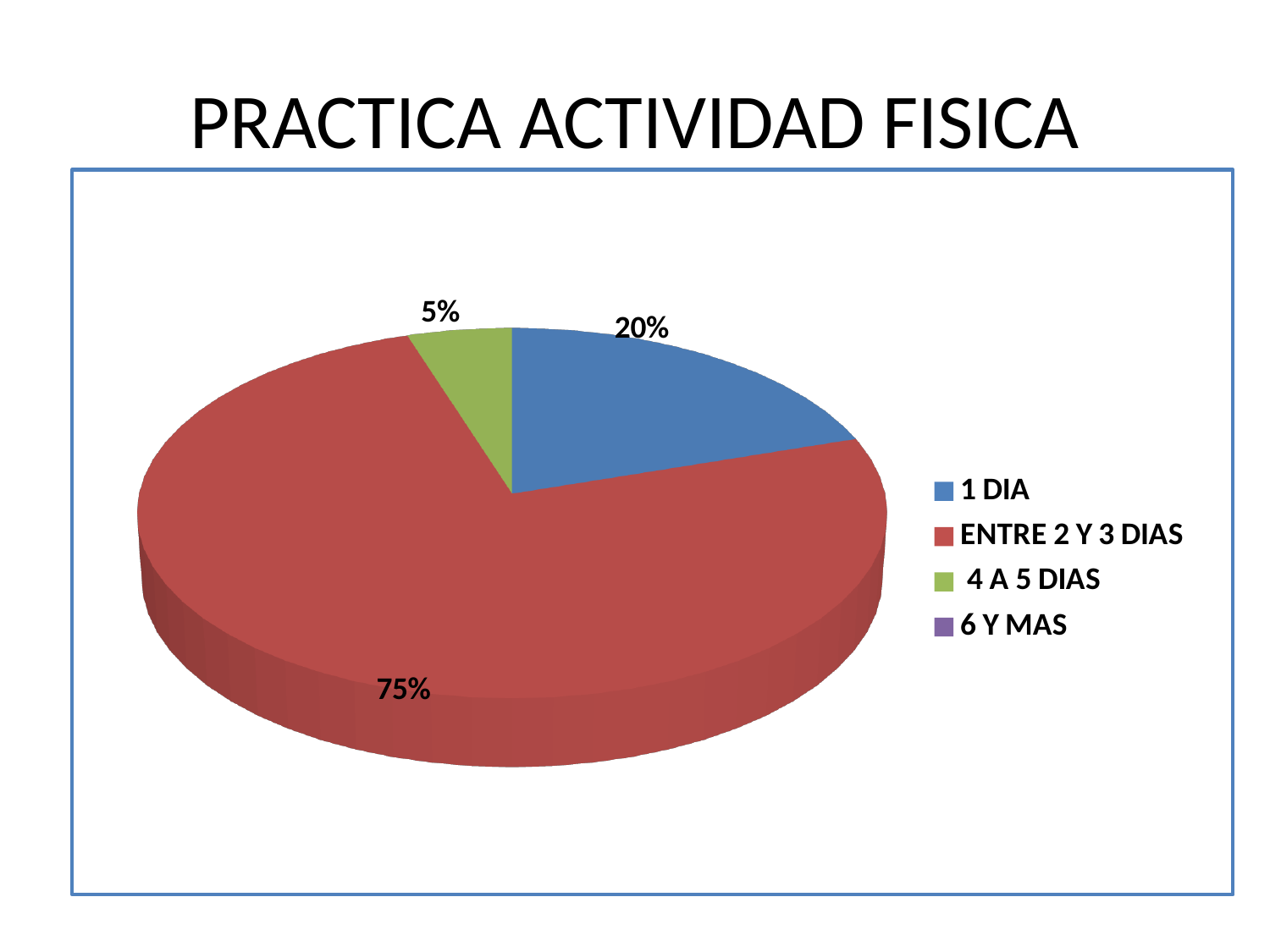
What share of the pie does 4 A 5 DIAS represent? 5% What is the difference between the shares for ENTRE 2 Y 3 DIAS and 1 DIA? 55% What share of the pie does 1 DIA represent? 20% What is the title of the slide? PRACTICA ACTIVIDAD FISICA How many categories does the legend list? 4 Which category has the largest slice of the pie? ENTRE 2 Y 3 DIAS What share of the pie does ENTRE 2 Y 3 DIAS represent? 75% What kind of chart is shown on the slide? pie chart Which of the labelled slices is the smallest? 4 A 5 DIAS Which is larger, the share for 1 DIA or the share for 4 A 5 DIAS? 1 DIA What is the difference between the shares for 1 DIA and 4 A 5 DIAS? 15% What colour is the slice for ENTRE 2 Y 3 DIAS? red